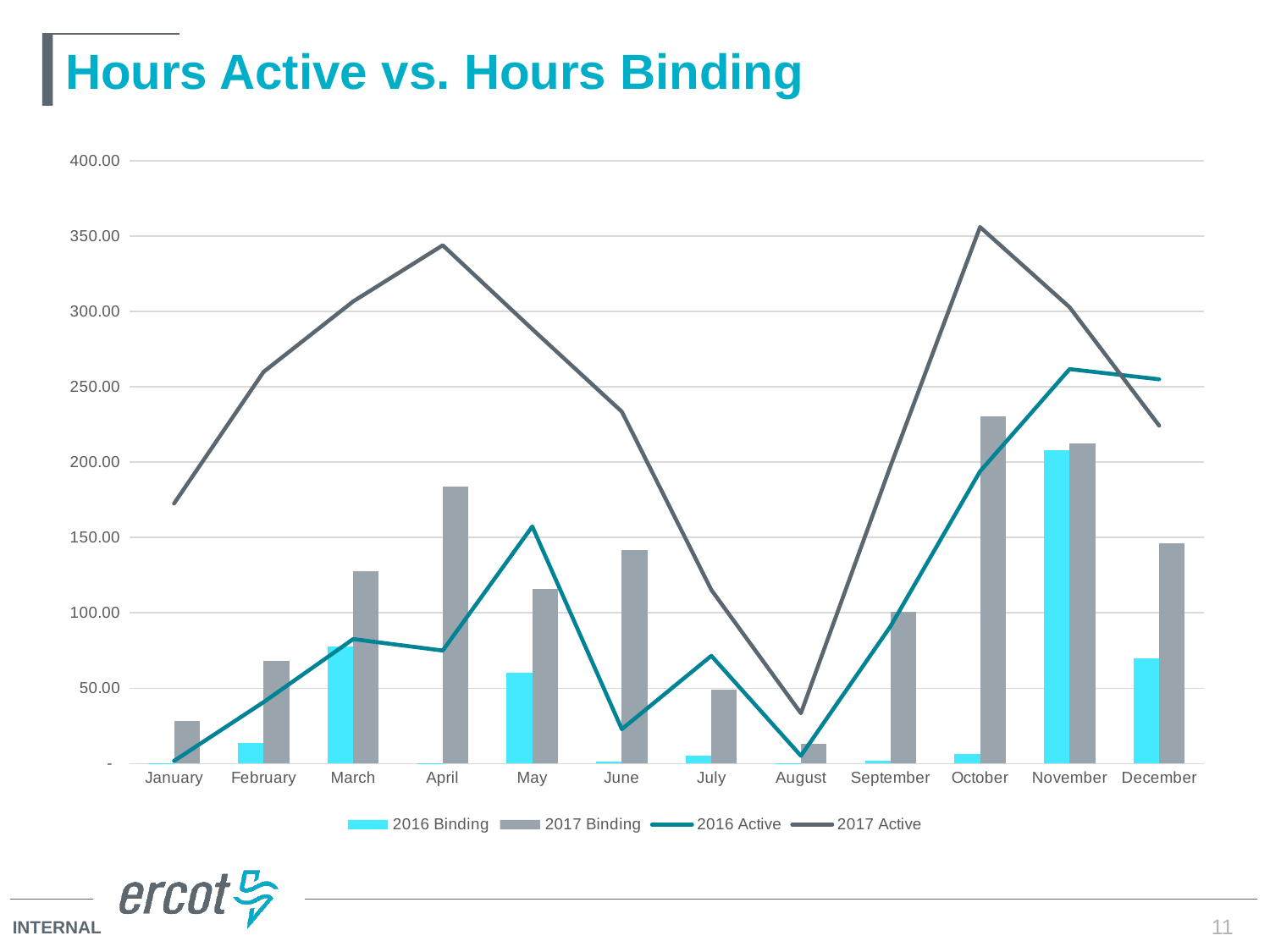
In which month does the 2017 Active line reach its lowest point? August Is the 2017 Binding value for April greater or less than 150? greater In which month is the 2017 Binding bar highest? October How many series does the legend list? 4 Does the 2017 Active line rise or fall from April to August? Fall Is the 2017 Active value for April greater or less than 300? greater In March, which is larger: the 2016 Binding bar or the 2017 Binding bar? 2017 Binding In which month is the 2016 Binding bar highest? November What kind of chart is shown on the slide? A combined bar and line chart In which month does the 2017 Active line reach its highest point? October Is the 2016 Binding value for November greater or less than 150? greater How many months are shown along the x axis? 12